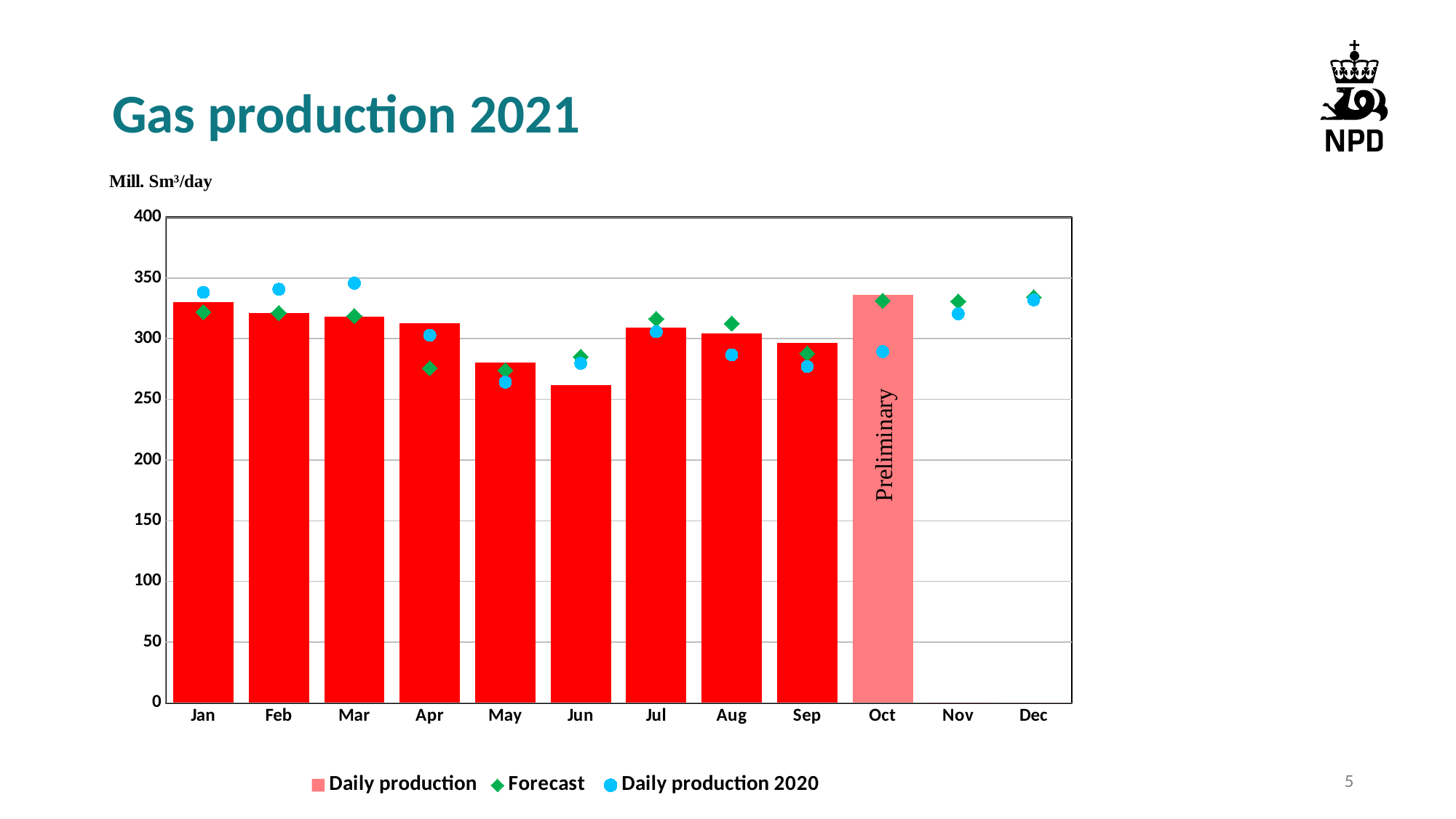
What word is written on the Oct bar? Preliminary Is the Daily production value for Jun greater or less than 300? less Is the Forecast value for Apr greater or less than 300? less Which is larger, the Daily production bar for Jan or for Jun? Jan Do the Daily production bars rise or fall from Jan to Jun? fall How many series does the legend list? 3 Which is larger, the Daily production bar for May or for Jul? Jul How many months are shown on the x axis? 12 Is the Daily production value for Jan greater or less than 300? greater Which month has the lowest Daily production bar? Jun What kind of chart is shown on the slide? bar chart